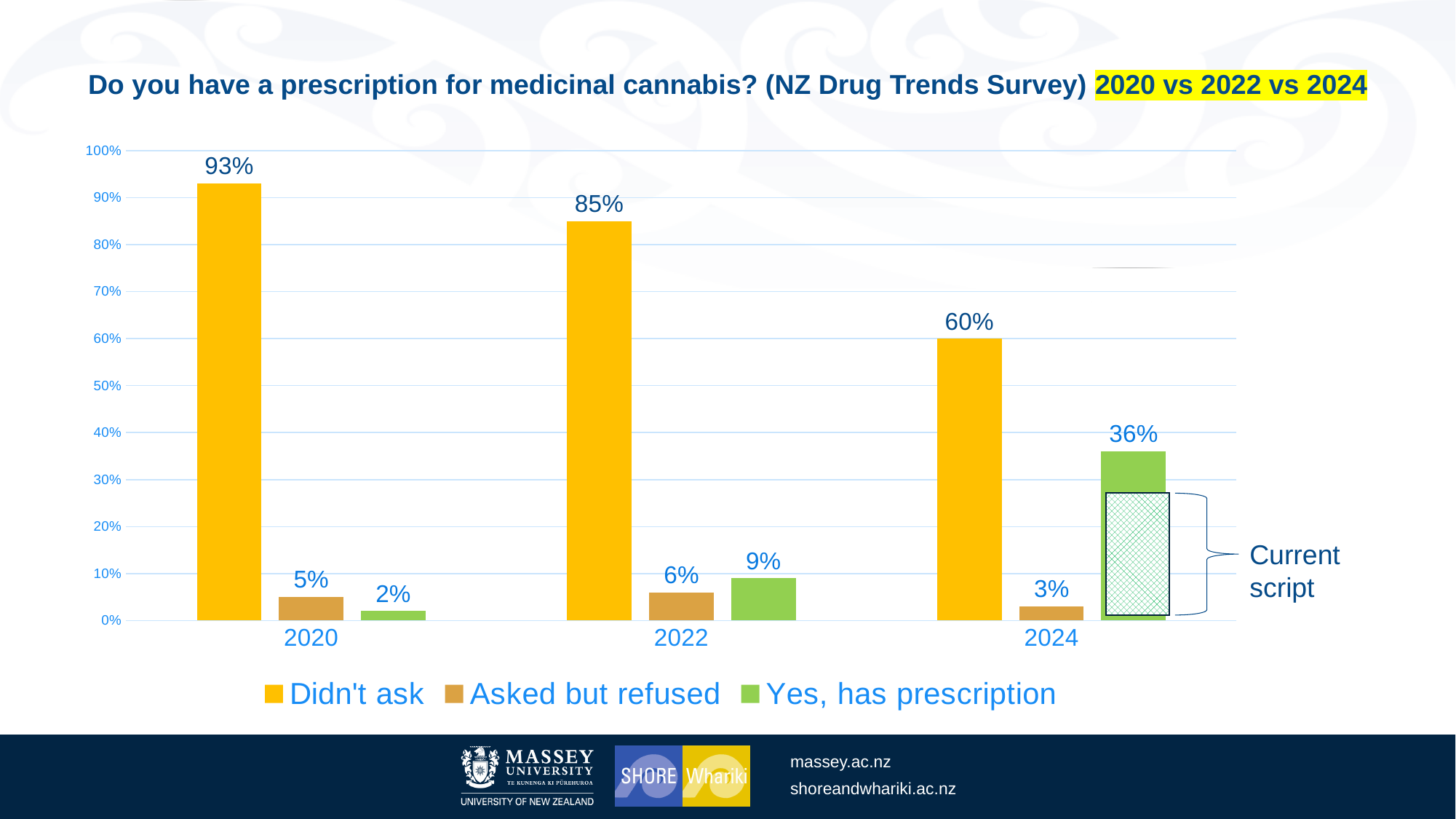
What is the value for 'Asked but refused' in 2022? 6% What kind of chart is shown on the slide? Bar chart How many years are shown on the x axis? 3 What percentage of respondents in 2020 said they didn't ask for a prescription? 93% What does the annotation next to the 2024 green bar say? Current script How many series does the legend list? 3 In which year is the 'Yes, has prescription' value highest? 2024 What is the difference between the 'Didn't ask' values for 2020 and 2024? 33 percentage points In which year is the 'Didn't ask' value lowest? 2024 How does the 'Didn't ask' series change from 2020 to 2024? It falls What is the value for 'Yes, has prescription' in 2024? 36% Which is larger in 2022: 'Asked but refused' or 'Yes, has prescription'? Yes, has prescription